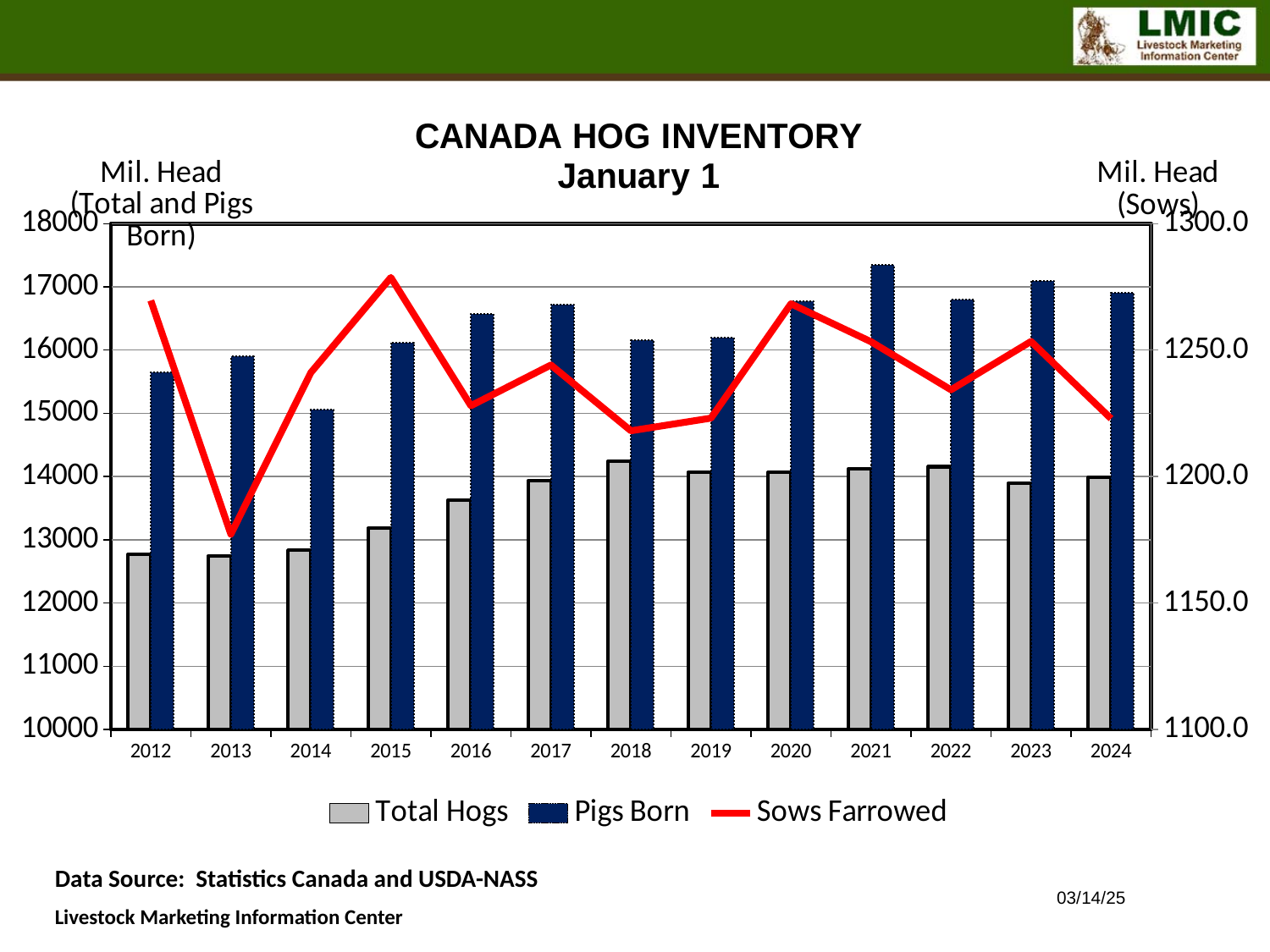
Which is larger, the Total Hogs value for 2016 or for 2013? 2016 What kind of chart is shown on the slide? A combination bar and line chart What is the title of the chart? CANADA HOG INVENTORY January 1 How many series does the legend list? 3 Is the Total Hogs value for 2012 greater or less than 13000? less Is the Pigs Born value for 2021 greater or less than 17000? greater Is the Sows Farrowed value for 2013 greater or less than 1200.0? less In which year is the Sows Farrowed value lowest? 2013 Which series is plotted as a red line? Sows Farrowed How many years are shown on the x axis of the chart? 13 In which year is the Pigs Born value lowest? 2014 In which year is the Pigs Born value highest? 2021